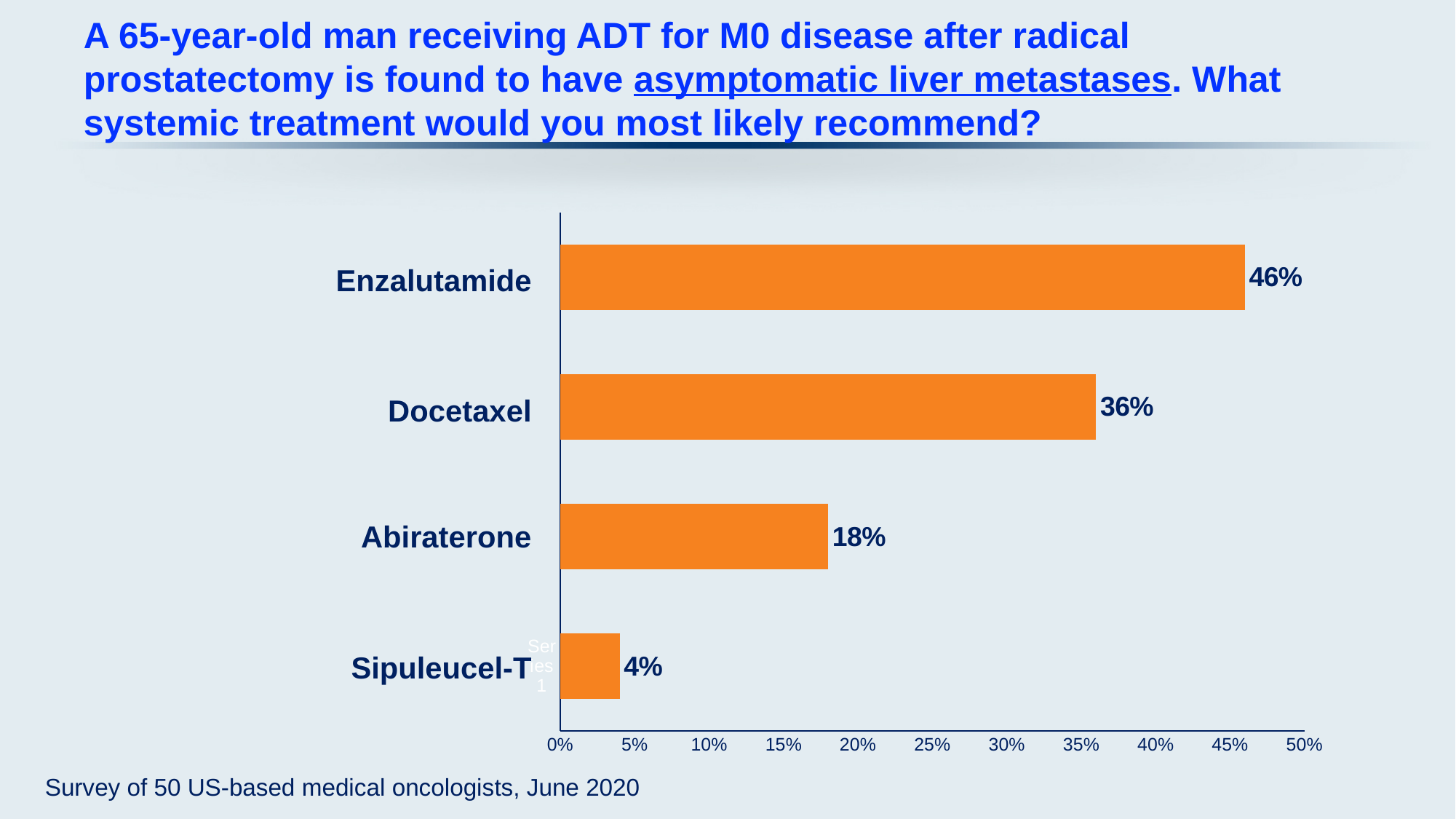
Which treatment has the highest percentage? Enzalutamide What percentage of respondents chose Enzalutamide? 46% Which has a larger value, Abiraterone or Docetaxel? Docetaxel What type of chart is shown on the slide? Bar chart How many treatment options are shown in the chart? 4 What is the value for Sipuleucel-T? 4% Is the value for Enzalutamide greater or less than 40%? greater What percentage is shown for Abiraterone? 18% What is the difference between the values for Docetaxel and Abiraterone? 18% What is the difference between the values for Enzalutamide and Docetaxel? 10% What is the value shown for Docetaxel? 36% Which treatment has the lowest percentage? Sipuleucel-T